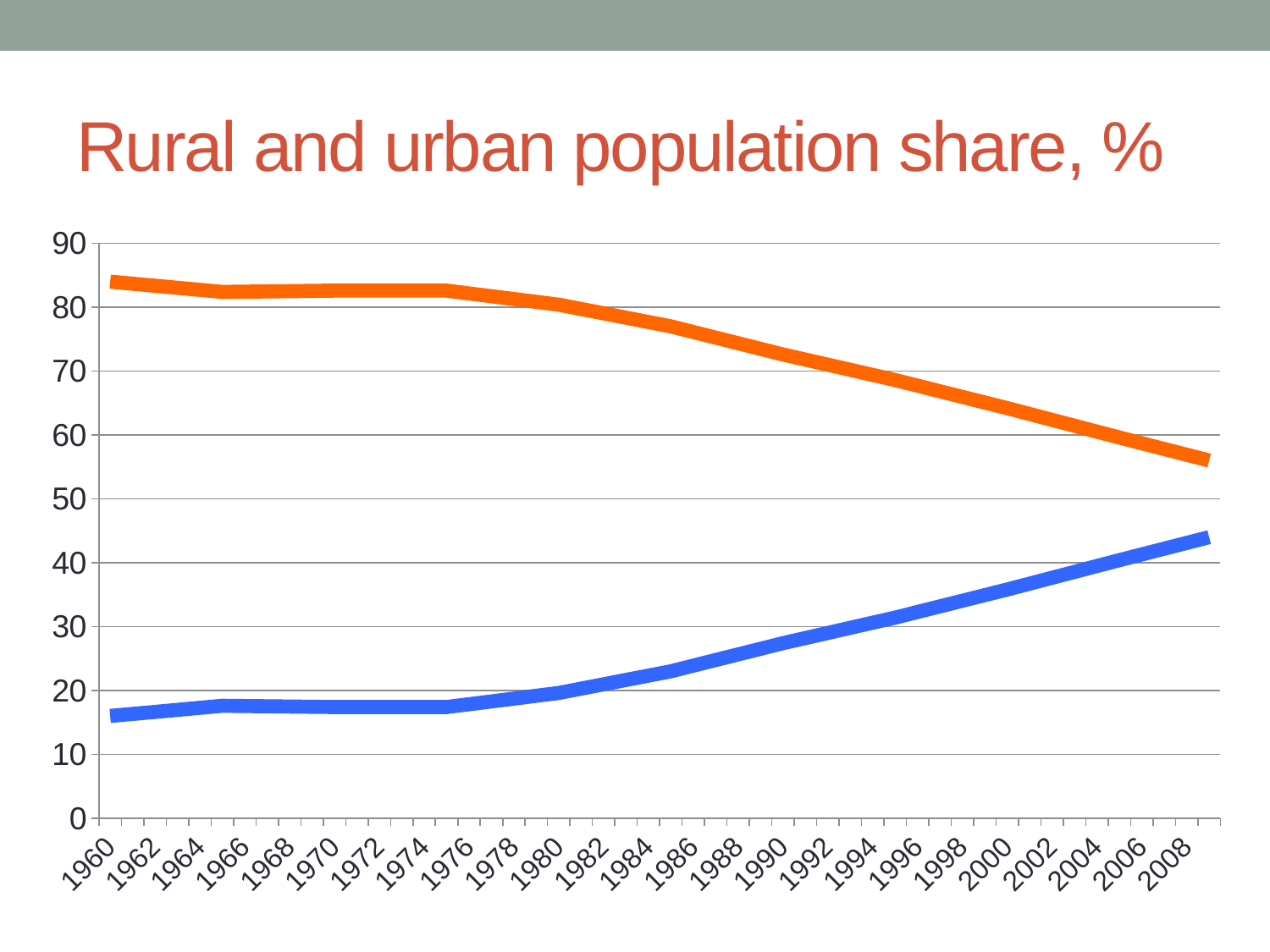
Is the value of the blue line in 2008 greater or less than 40? greater What is the title of the chart? Rural and urban population share, % What kind of chart is shown on the slide? line chart Does the orange line rise or fall from 1960 to 2008? fall Is the value of the orange line in 2008 greater or less than 60? less Is the value of the orange line in 1960 greater or less than 80? greater What is the highest value shown on the y axis? 90 Does the blue line rise or fall from 1960 to 2008? rise How many year labels are shown on the x axis? 25 In 2008, which line has the higher value, the orange line or the blue line? orange line